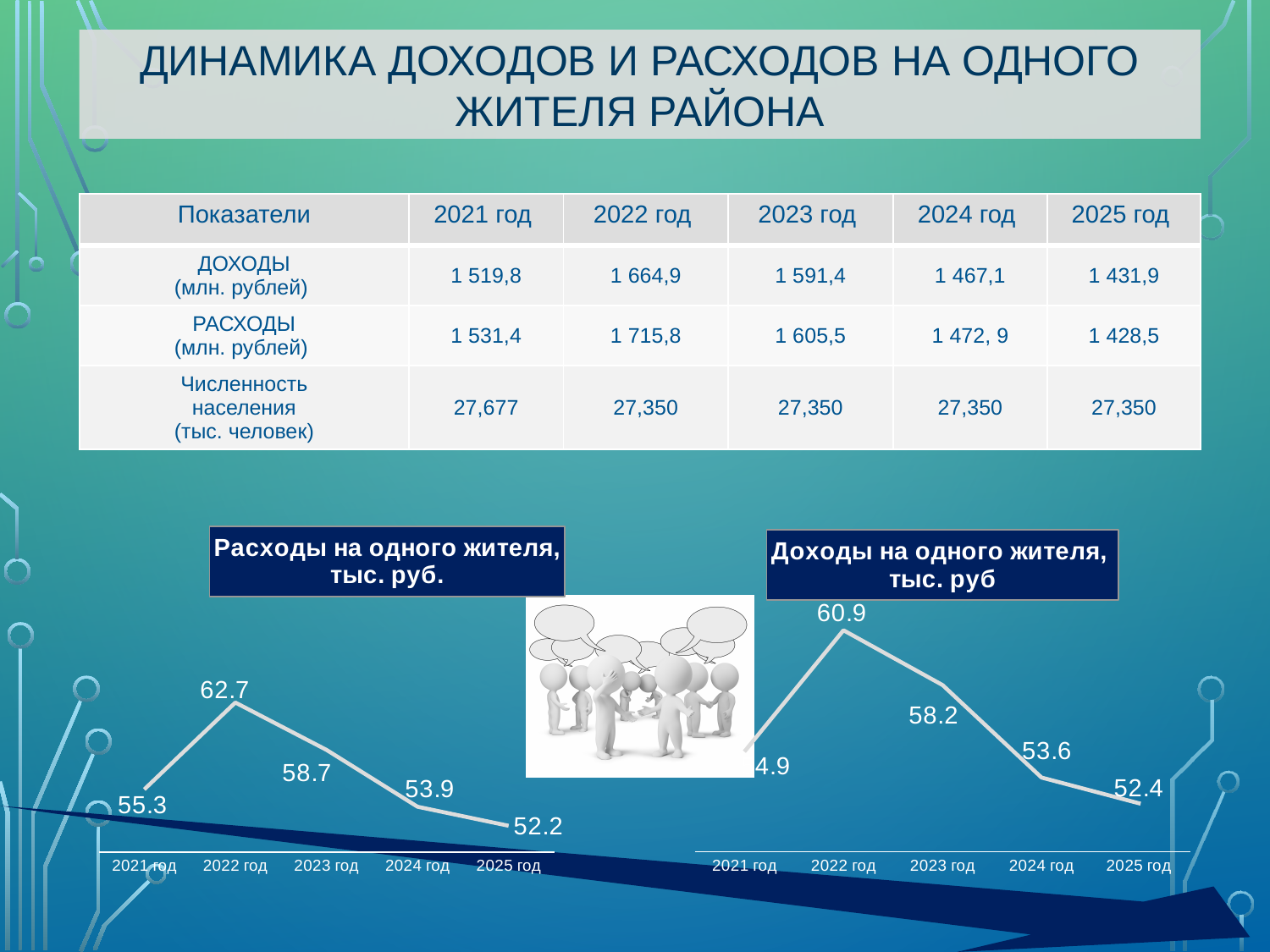
On the chart 'Доходы на одного жителя, тыс. руб', which year has the highest value? 2022 год How many years are plotted on the chart 'Расходы на одного жителя, тыс. руб.'? 5 On the chart 'Расходы на одного жителя, тыс. руб.', what is the difference between the values for 2022 год and 2025 год? 10.5 On the chart 'Доходы на одного жителя, тыс. руб', what is the value for 2023 год? 58.2 What kind of chart is 'Доходы на одного жителя, тыс. руб'? line chart On the chart 'Доходы на одного жителя, тыс. руб', what is the value for 2025 год? 52.4 On the chart 'Расходы на одного жителя, тыс. руб.', what is the value for 2022 год? 62.7 On the chart 'Расходы на одного жителя, тыс. руб.', what is the value for 2025 год? 52.2 On the chart 'Расходы на одного жителя, тыс. руб.', which year has the highest value? 2022 год On the chart 'Расходы на одного жителя, тыс. руб.', which year has the lowest value? 2025 год On the chart 'Расходы на одного жителя, тыс. руб.', what is the value for 2021 год? 55.3 On the chart 'Доходы на одного жителя, тыс. руб', which is larger, the value for 2023 год or the value for 2024 год? 2023 год